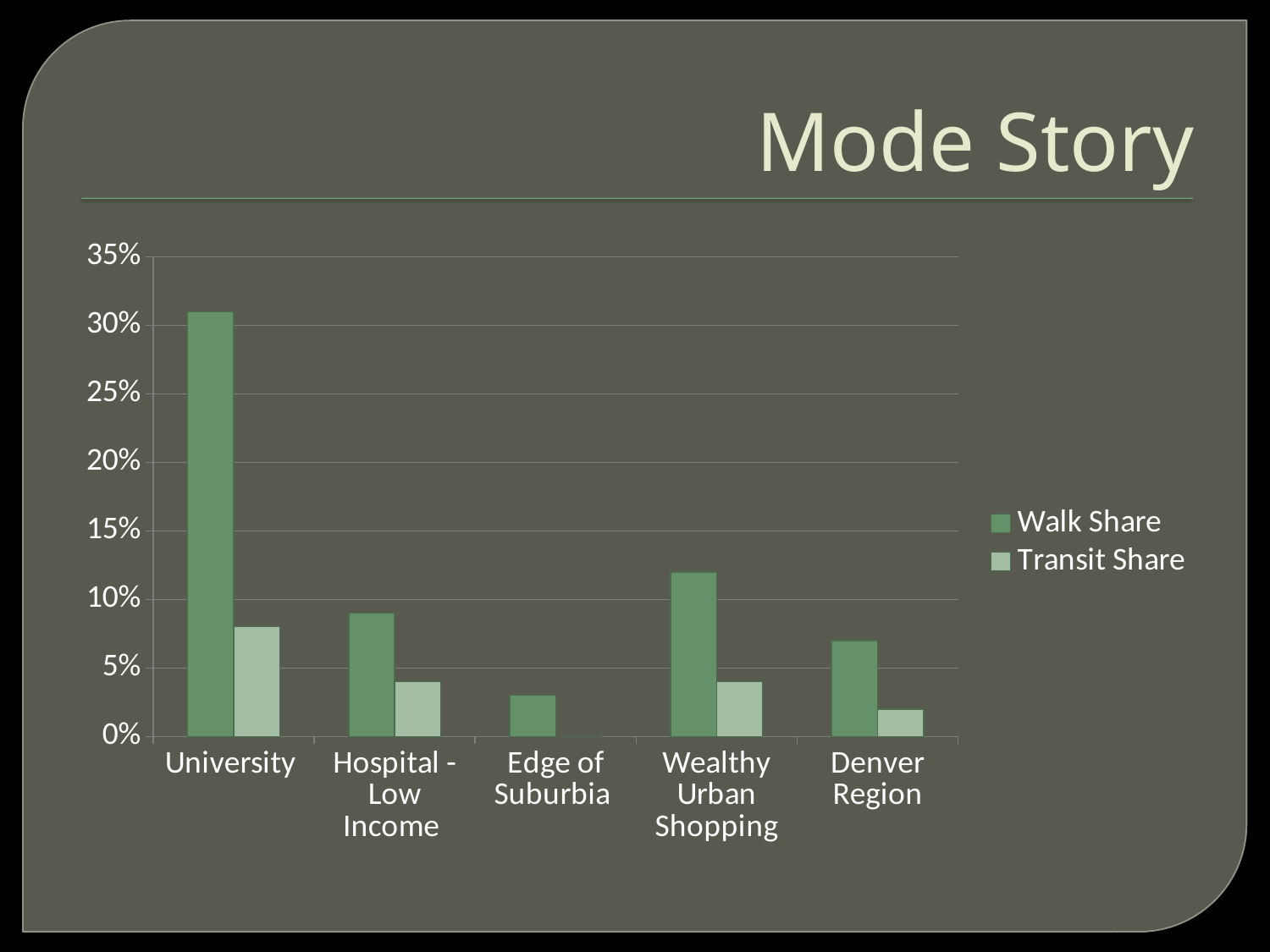
Which has a larger Walk Share, Wealthy Urban Shopping or Hospital - Low Income? Wealthy Urban Shopping Which category has the highest Transit Share? University Which category has the lowest Walk Share? Edge of Suburbia Is the Walk Share for Edge of Suburbia greater or less than 5%? less Is the Walk Share for University greater or less than 25%? greater What is the title of the slide? Mode Story Is the Walk Share for Wealthy Urban Shopping greater or less than 10%? greater How many series does the legend list? 2 Which has a larger Transit Share, Hospital - Low Income or Denver Region? Hospital - Low Income What kind of chart is shown on the slide? bar chart Which category has the highest Walk Share? University How many categories are shown on the x axis? 5